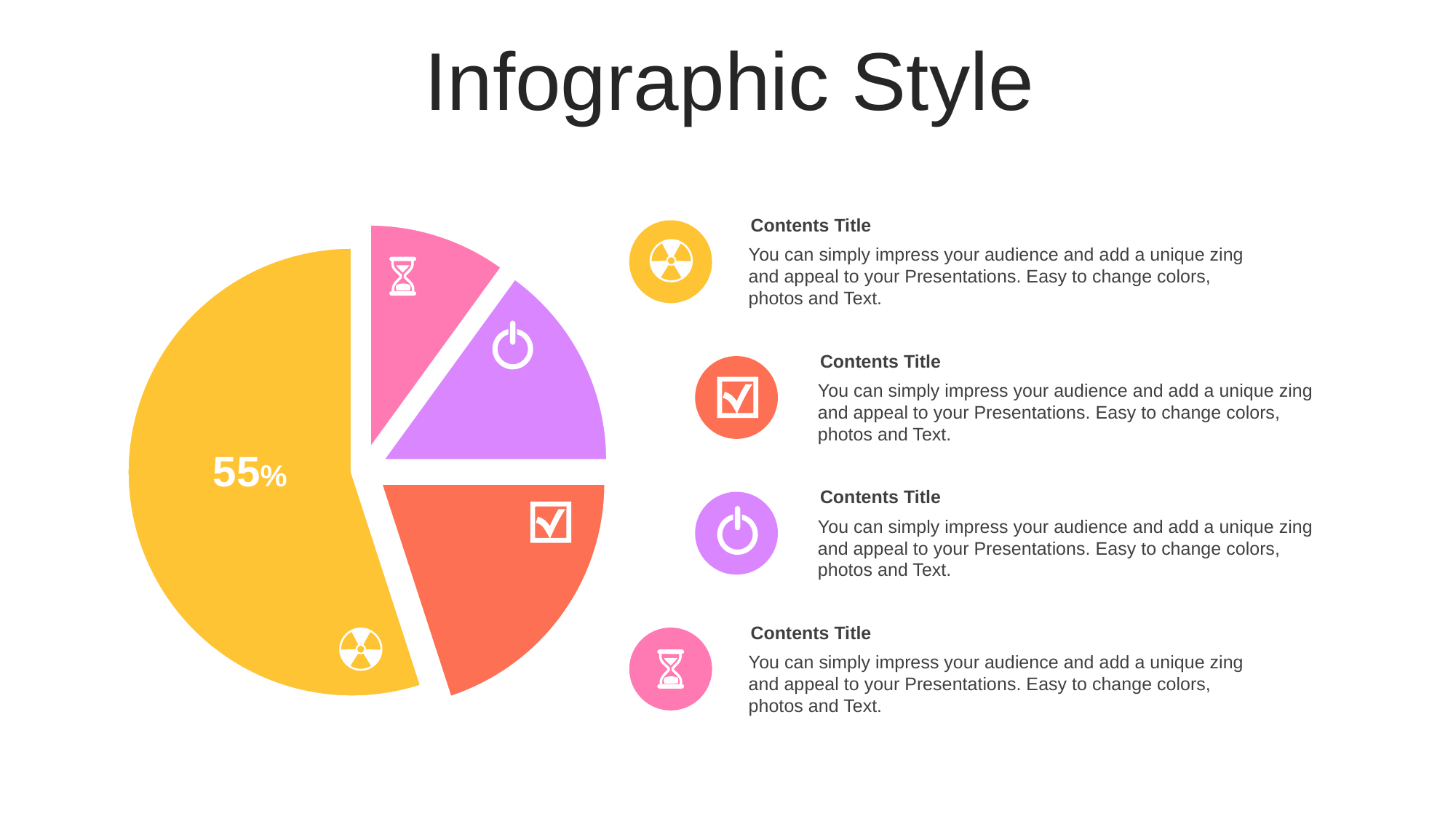
Which is larger, the purple slice or the pink slice? the purple slice What is the title of the slide containing the pie chart? Infographic Style Which is larger, the yellow slice or the orange slice? the yellow slice Which slice of the pie chart is the largest? the yellow slice What percentage is printed on the yellow slice of the pie chart? 55% What share of the pie does the yellow slice represent? 55% How many slices does the pie chart have? 4 Is the yellow slice greater or less than 50% of the pie? greater What kind of chart is shown on the slide? pie chart What colour is the slice labelled 55%? yellow Which slice of the pie chart is the smallest? the pink slice